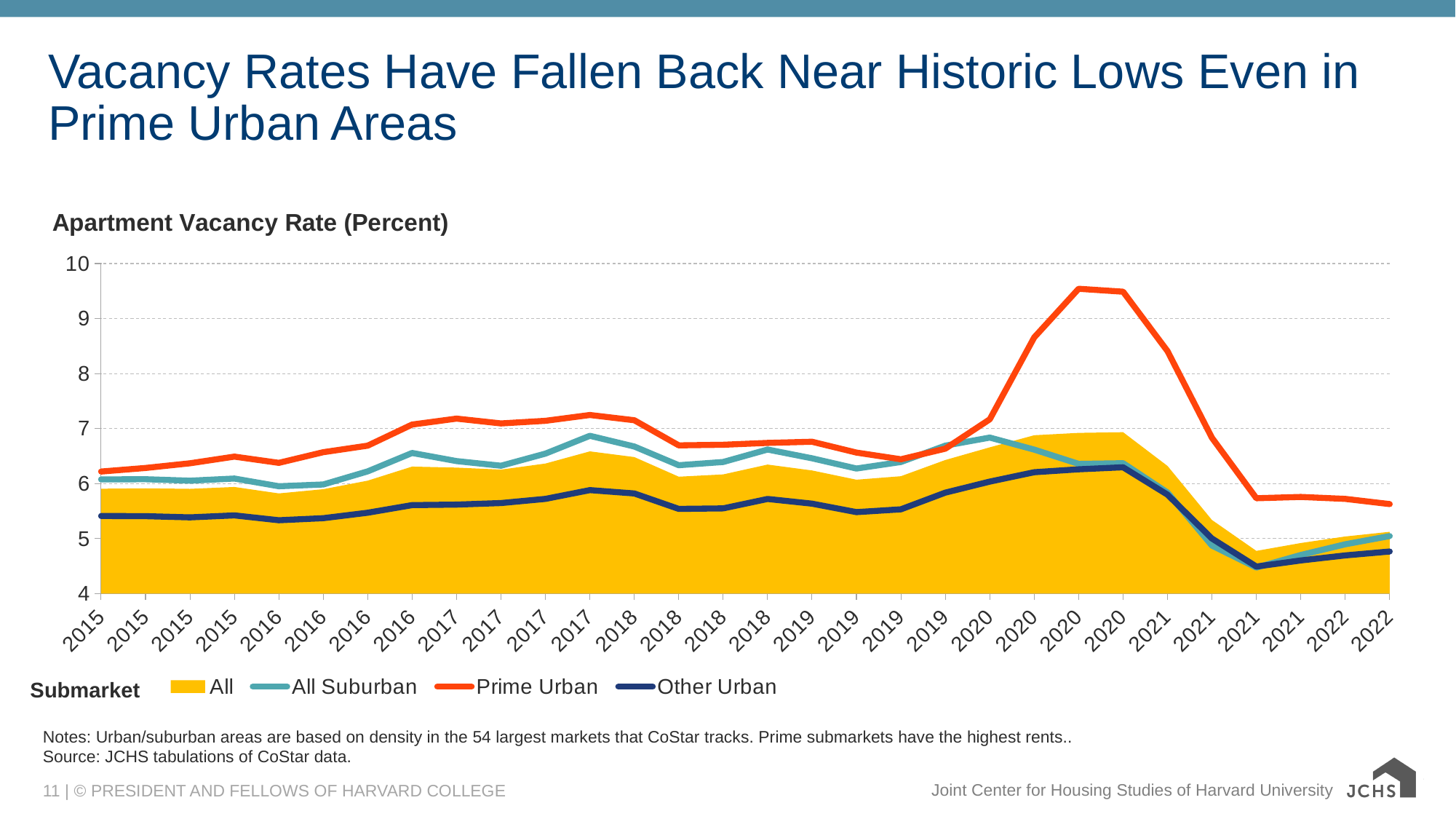
Is the peak value for Prime Urban in 2020 greater or less than 9? greater What kind of chart is this? combination area and line chart At the 2020 peak, which is larger: Prime Urban or Other Urban? Prime Urban Is the value for All Suburban at the last 2022 point greater or less than 6? less What label appears to the left of the legend entries? Submarket Is the value for Other Urban at the first 2015 point greater or less than 6? less What is the chart's title? Apartment Vacancy Rate (Percent) How many series does the legend list? 4 Which series has the highest value at its 2020 peak? Prime Urban Which series has the lowest value at the first 2015 point? Other Urban Does the Prime Urban series rise or fall from its 2020 peak through 2021? fall